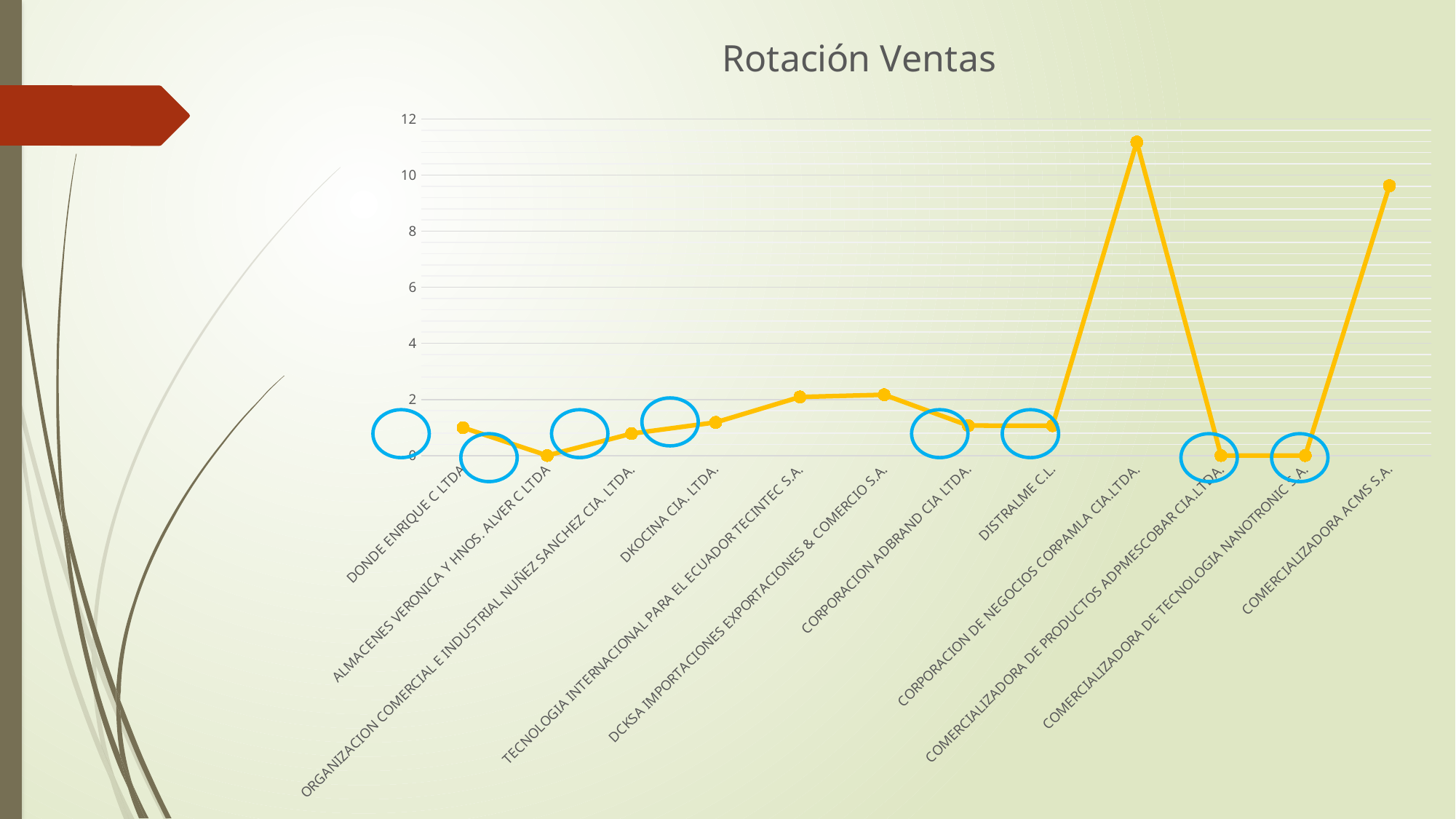
What is the value for COMERCIALIZADORA DE TECNOLOGIA NANOTRONIC S.A.? 0 Which has the larger value, DCKSA IMPORTACIONES EXPORTACIONES & COMERCIO S.A. or DONDE ENRIQUE C LTDA? DCKSA IMPORTACIONES EXPORTACIONES & COMERCIO S.A. Is the value for CORPORACION DE NEGOCIOS CORPAMLA CIA.LTDA. greater or less than 10? greater Which company has the highest value in the chart? CORPORACION DE NEGOCIOS CORPAMLA CIA.LTDA. Which has the larger value, CORPORACION DE NEGOCIOS CORPAMLA CIA.LTDA. or COMERCIALIZADORA ACMS S.A.? CORPORACION DE NEGOCIOS CORPAMLA CIA.LTDA. Is the value for COMERCIALIZADORA ACMS S.A. greater or less than 8? greater Is the value for COMERCIALIZADORA ACMS S.A. greater or less than 10? less How many companies are plotted along the x axis of the chart? 12 Does the line rise or fall from CORPORACION DE NEGOCIOS CORPAMLA CIA.LTDA. to COMERCIALIZADORA DE PRODUCTOS ADPMESCOBAR CIA.LTDA.? fall What kind of chart is shown on the slide? line chart What is the title of the chart? Rotación Ventas